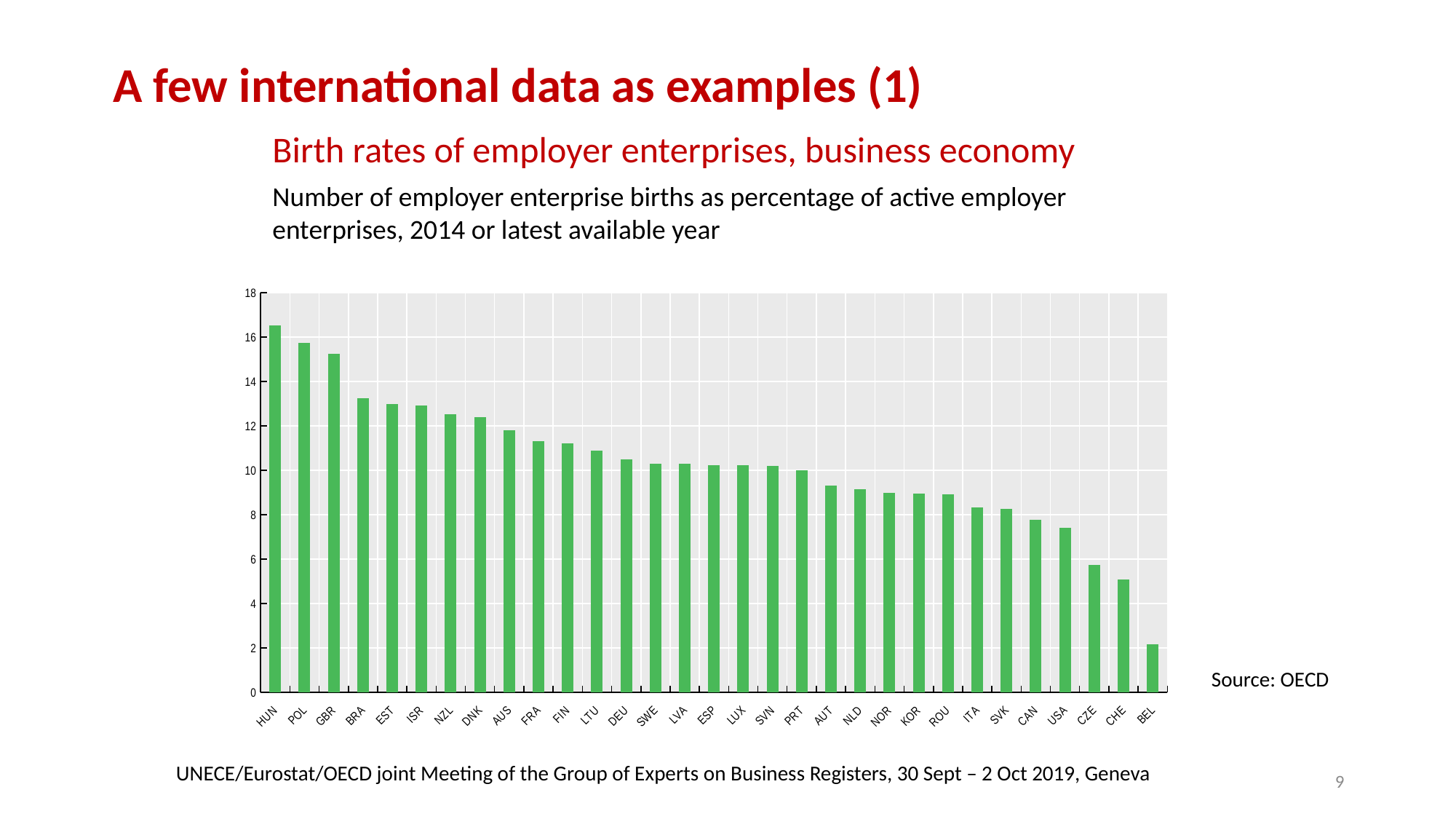
What kind of chart is shown on the slide? bar chart Is the value for BEL greater or less than 4? less Is the value for USA greater or less than 8? less Which has the larger value, CHE or AUS? AUS How many countries are shown on the x axis of the chart? 31 Do the values rise or fall moving from left to right along the x axis? fall Which country has the highest birth rate of employer enterprises in the chart? HUN Is the value for BRA greater or less than 12? greater Which country has the lowest birth rate of employer enterprises in the chart? BEL What is the source of the data shown in the chart? OECD Which has the larger value, GBR or CZE? GBR